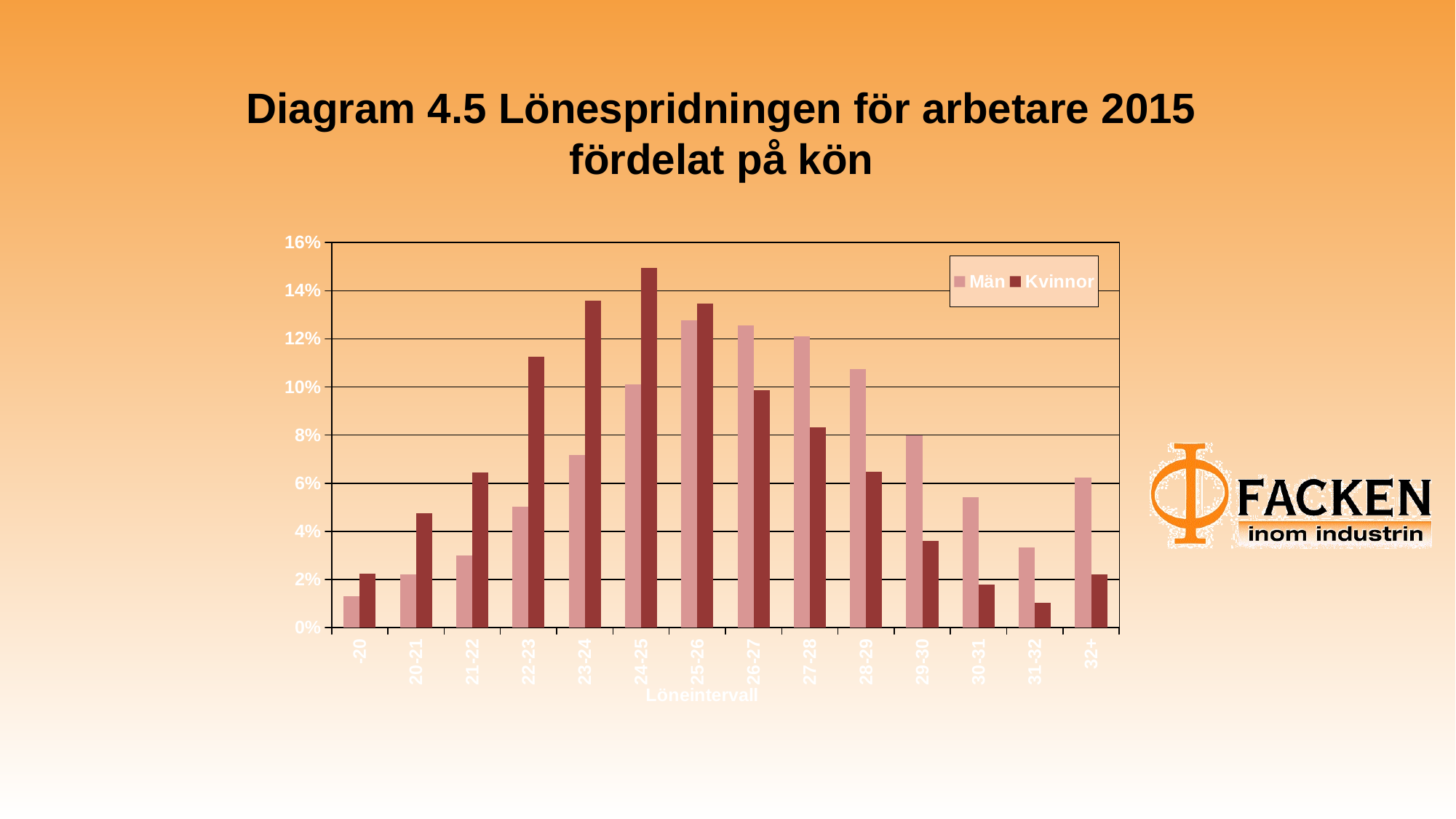
How many series does the legend list? 2 In which wage interval is the Män value lowest? -20 In which wage interval is the Kvinnor value lowest? 31-32 In which wage interval is the Kvinnor value highest? 24-25 Is the Kvinnor value for 24-25 greater or less than 14%? greater Is the Män value for 30-31 greater or less than 4%? greater For the 28-29 interval, which series has the larger value, Män or Kvinnor? Män What is the label of the x axis? Löneintervall How many wage intervals (categories) are shown on the x axis? 14 For the 22-23 interval, which series has the larger value, Män or Kvinnor? Kvinnor Is the Kvinnor value for 22-23 greater or less than 10%? greater What kind of chart is shown on the slide? bar chart